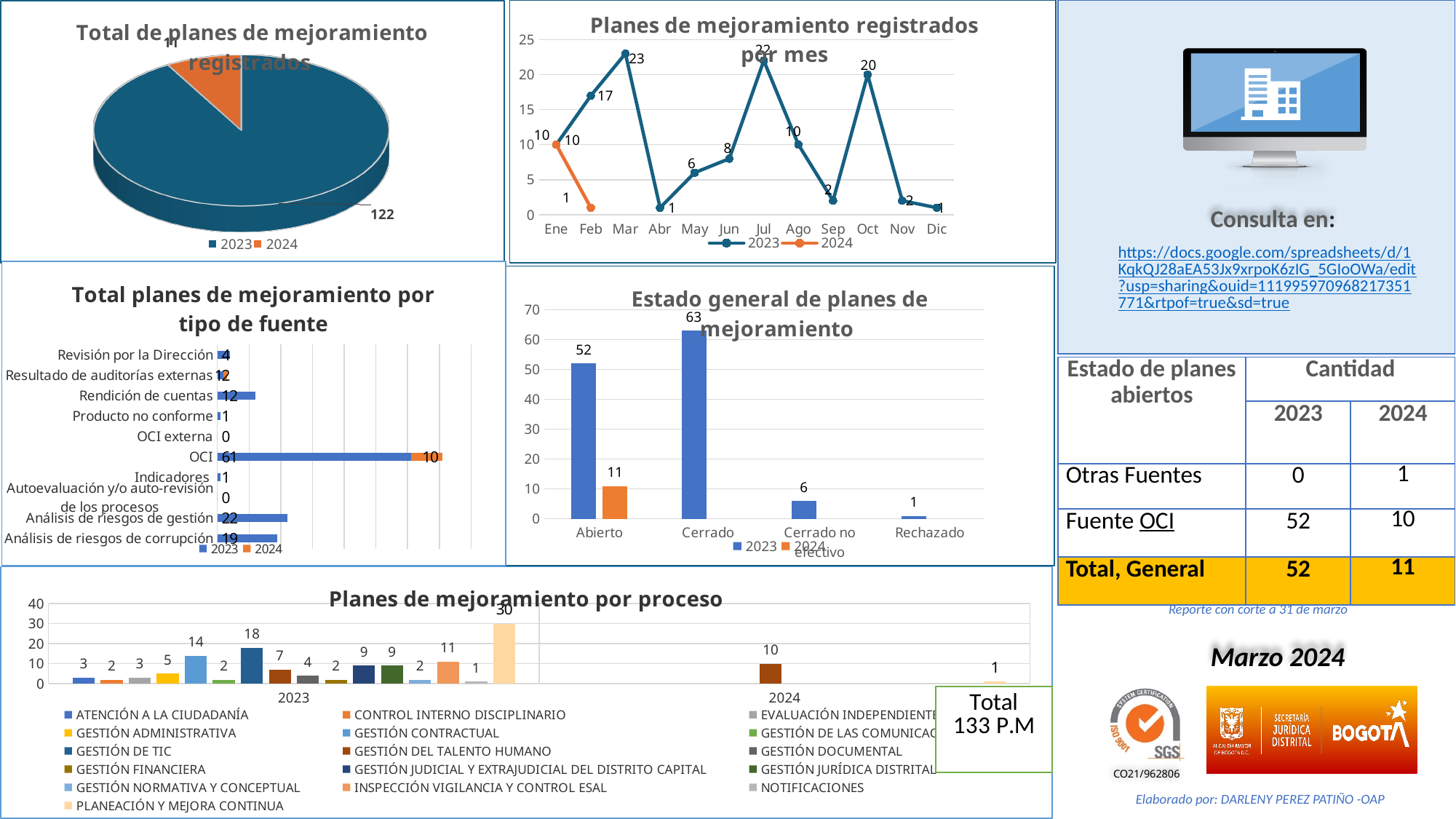
In the chart 'Planes de mejoramiento registrados por mes', what is the 2023 value for Mar? 23 In the chart 'Estado general de planes de mejoramiento', what is the 2023 value for Cerrado? 63 In the chart 'Planes de mejoramiento por proceso', what is the 2023 value for PLANEACIÓN Y MEJORA CONTINUA? 30 In the chart 'Total planes de mejoramiento por tipo de fuente', what is the 2023 value for OCI? 61 In the chart 'Planes de mejoramiento registrados por mes', what is the difference between the 2023 values for Jul and Ago? 12 In the chart 'Total planes de mejoramiento por tipo de fuente', which is larger for 2023: Análisis de riesgos de gestión or Análisis de riesgos de corrupción? Análisis de riesgos de gestión In the chart 'Planes de mejoramiento registrados por mes', do the 2024 values rise or fall from Ene to Feb? fall In the chart 'Estado general de planes de mejoramiento', what is the difference between the 2023 and 2024 values for Abierto? 41 In the chart 'Planes de mejoramiento registrados por mes', which month has the highest 2023 value? Mar In the chart 'Planes de mejoramiento registrados por mes', how many series does the legend list? 2 What kind of chart is 'Total de planes de mejoramiento registrados'? pie chart In the chart 'Total de planes de mejoramiento registrados', what is the value for 2023? 122